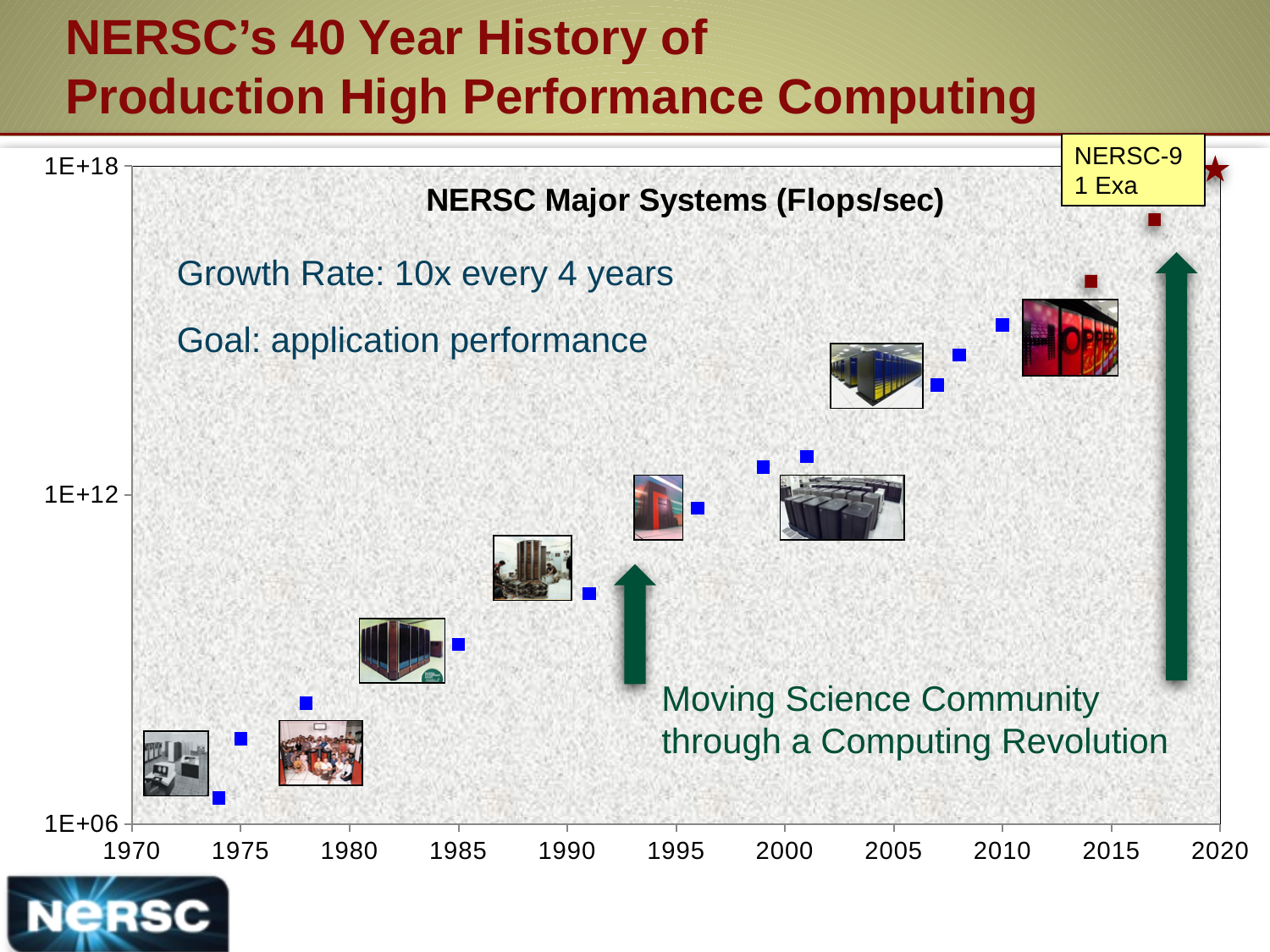
Is the value plotted for 1985 greater or less than 1E+12? less Is the value plotted for 2010 greater or less than 1E+12? greater Is the value plotted for 2017 greater or less than 1E+18? less Which year has the highest plotted value on the chart? 2020 What is the title of the chart? NERSC Major Systems (Flops/sec) What performance is labeled for the NERSC-9 system at 2020? 1 Exa What kind of chart is shown on the slide? scatter chart What is the highest value shown on the y axis? 1E+18 Do the plotted values rise or fall as the years increase along the x axis? rise Which year has the lowest plotted value on the chart? 1974